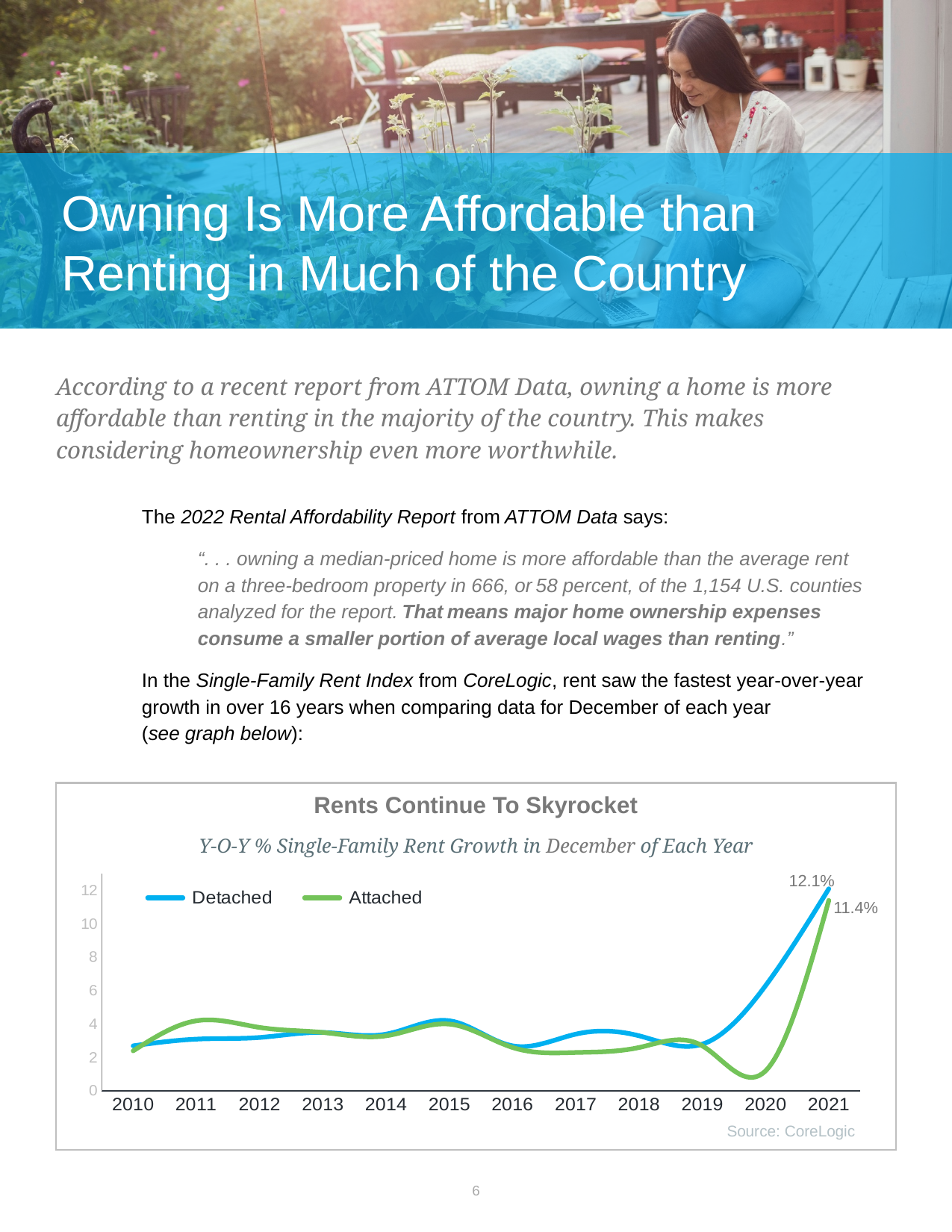
In 2021, which series has the higher value, Detached or Attached? Detached What is the title of the chart? Rents Continue To Skyrocket How many years are shown along the x axis of the chart? 12 Is the Attached value for 2020 greater or less than 2? less In which year is the Detached series at its highest? 2021 What is the Attached rent growth value for 2021? 11.4% What is the difference between the Detached and Attached values in 2021? 0.7% What kind of chart is shown on the slide? line chart Is the Detached value for 2020 greater or less than 4? greater In which year is the Attached series at its lowest? 2020 What is the Detached rent growth value for 2021? 12.1% How many series does the chart's legend list? 2